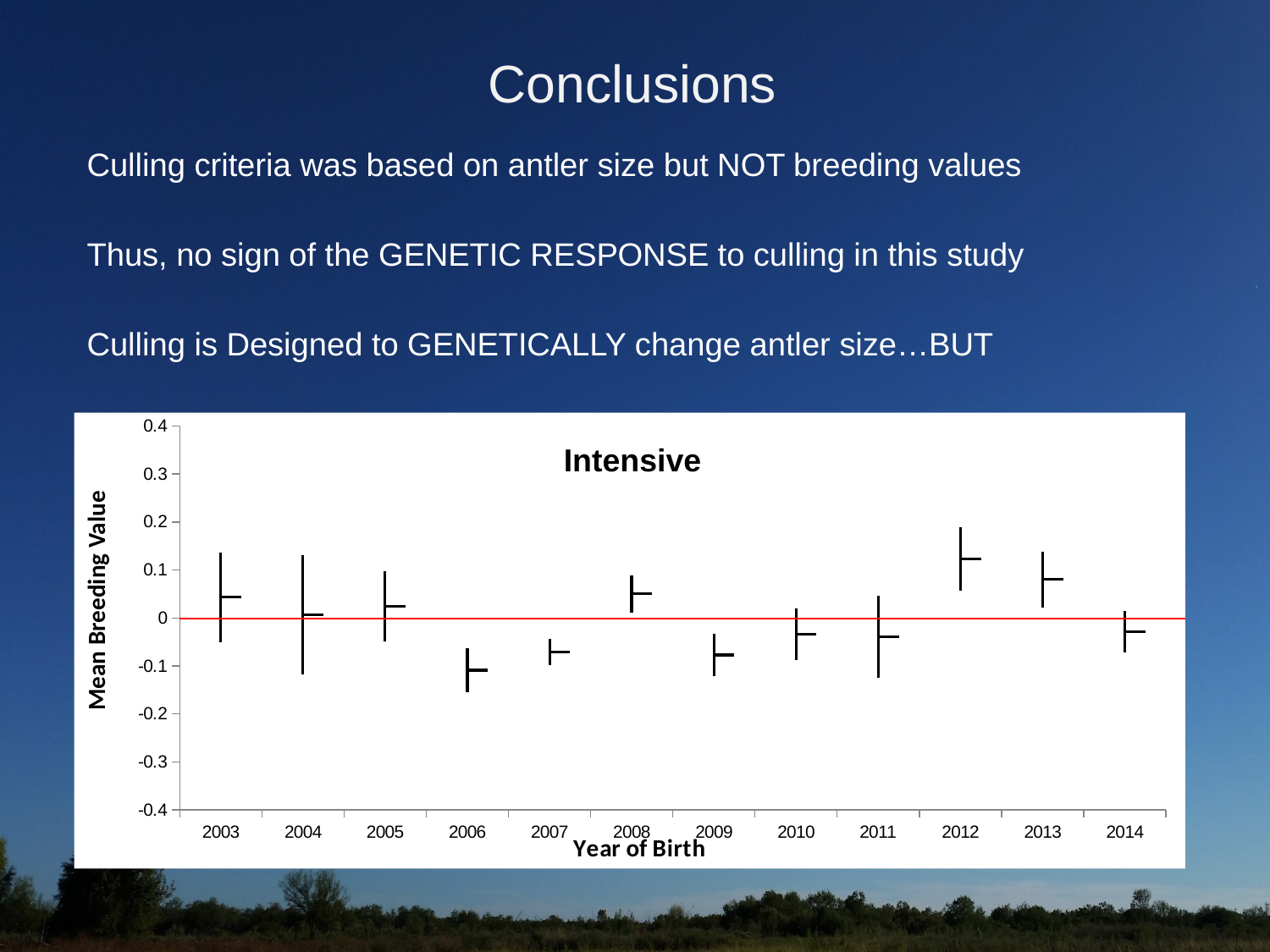
Is the mean breeding value for 2012 greater or less than 0? greater Which year of birth has the lowest mean breeding value in the chart? 2006 Is the mean breeding value for 2006 greater or less than 0? less Which year of birth has the highest mean breeding value in the chart? 2012 Which has the larger mean breeding value, 2008 or 2009? 2008 What is the first year shown on the x axis of the chart? 2003 Is the mean breeding value for 2009 greater or less than 0? less How many years of birth are plotted on the x axis of the chart? 12 What is the label of the y axis of the chart? Mean Breeding Value Which has the larger mean breeding value, 2012 or 2006? 2012 What is the title shown inside the chart? Intensive